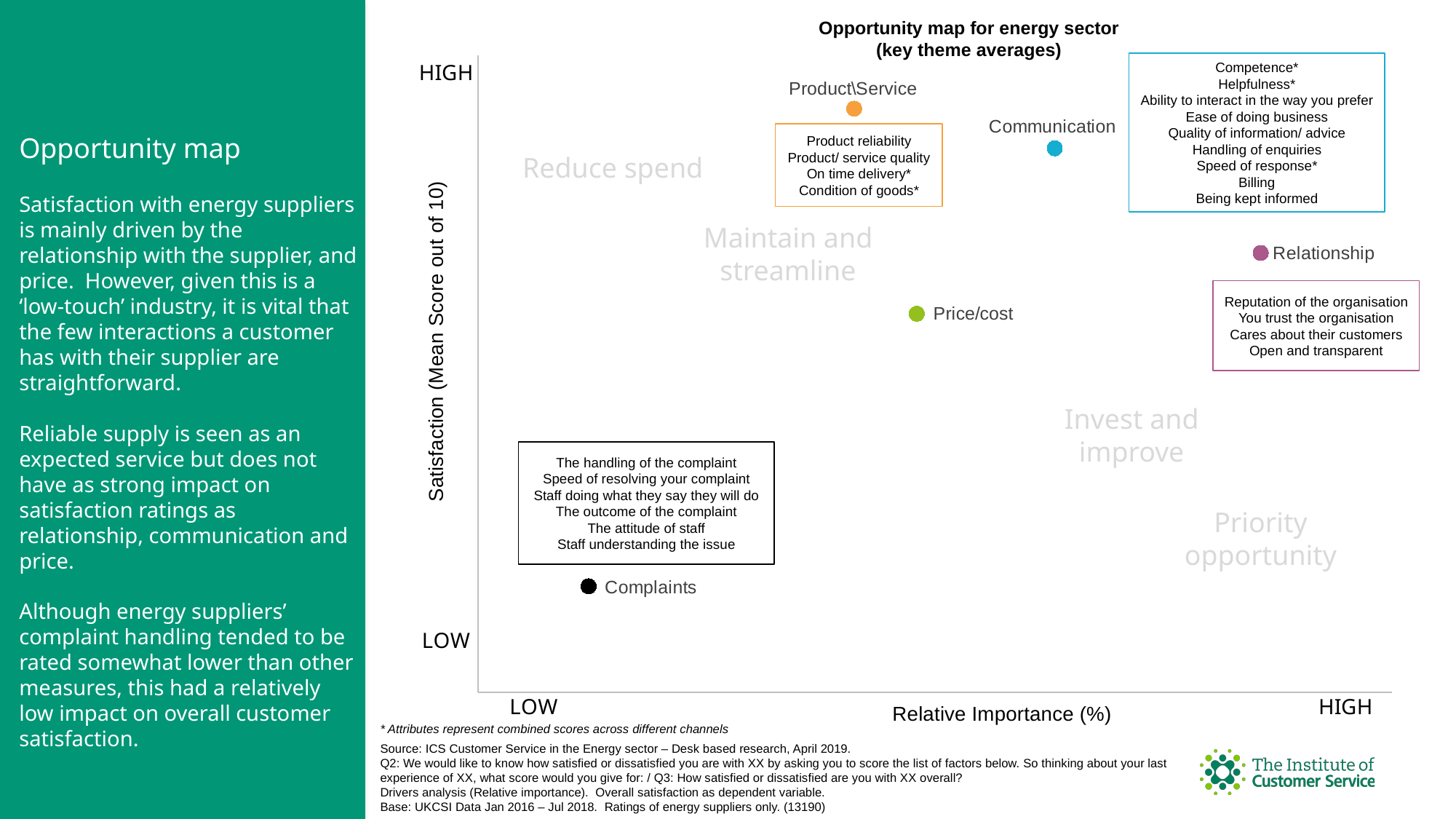
What is the title of the chart? Opportunity map for energy sector (key theme averages) Which has higher satisfaction, Communication or Relationship? Communication What is the label of the vertical axis of the chart? Satisfaction (Mean Score out of 10) Which key theme has the highest relative importance on the chart? Relationship Which key theme has the lowest relative importance on the chart? Complaints Which has higher relative importance, Communication or Complaints? Communication How many key themes are plotted as points on the chart? 5 Which key theme has the highest satisfaction (mean score) on the chart? Product\Service Which key theme has the lowest satisfaction (mean score) on the chart? Complaints Which has higher satisfaction, Product\Service or Price/cost? Product\Service What kind of chart is the opportunity map on the slide? Scatter chart